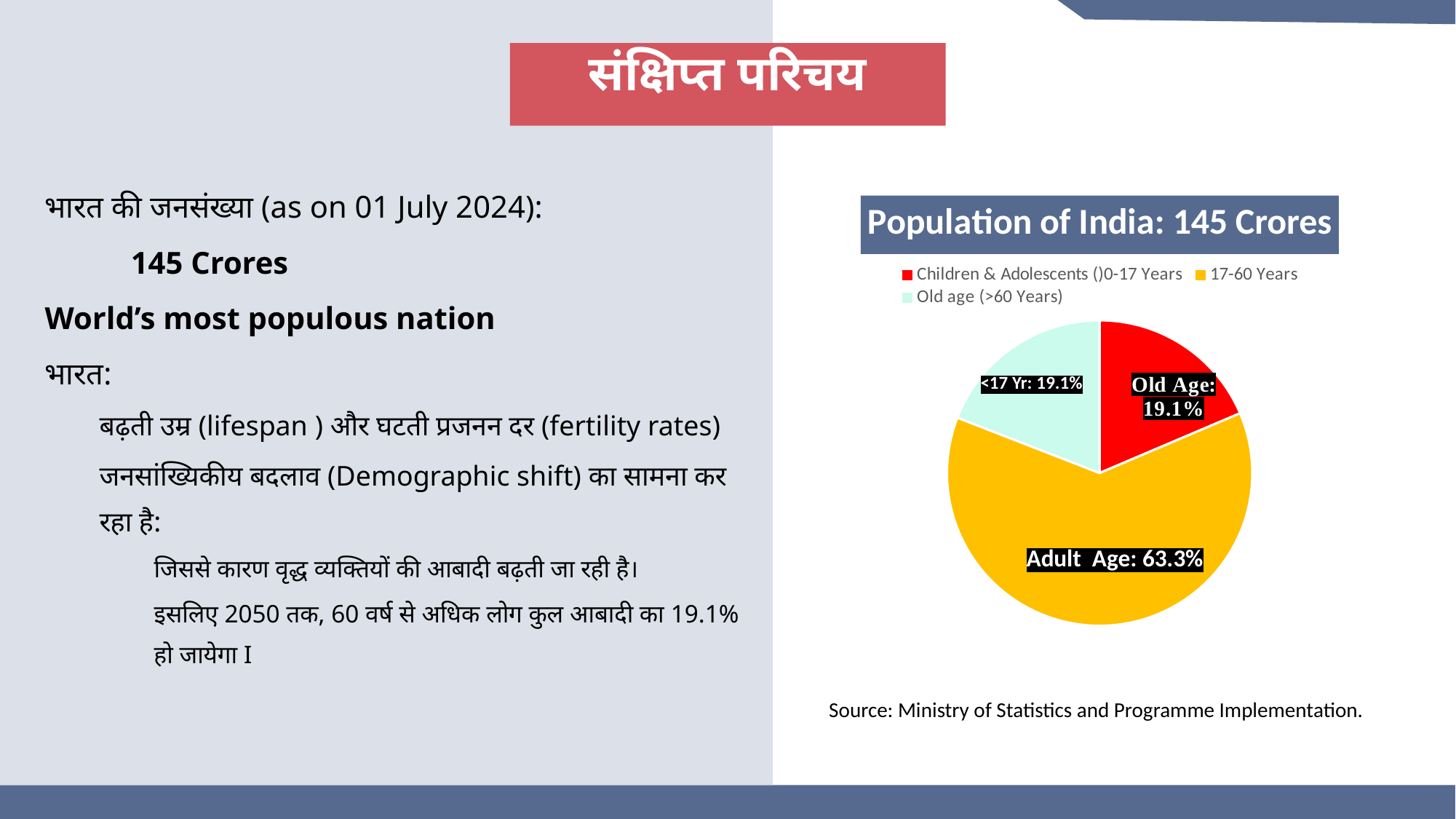
What percentage is shown for the Adult Age slice? 63.3% Which slice of the pie chart is the largest? Adult Age What colour does the legend use for the 17-60 Years entry? Yellow What kind of chart is shown on the slide? Pie chart What percentage is shown for the <17 Yr slice? 19.1% How many entries does the chart's legend list? 3 Which is larger, the Adult Age slice or the Old Age slice? Adult Age How many slices does the pie chart have? 3 What percentage is shown for the Old Age slice? 19.1% By how many percentage points does the Adult Age slice exceed the Old Age slice? 44.2 What is the title of the chart? Population of India: 145 Crores